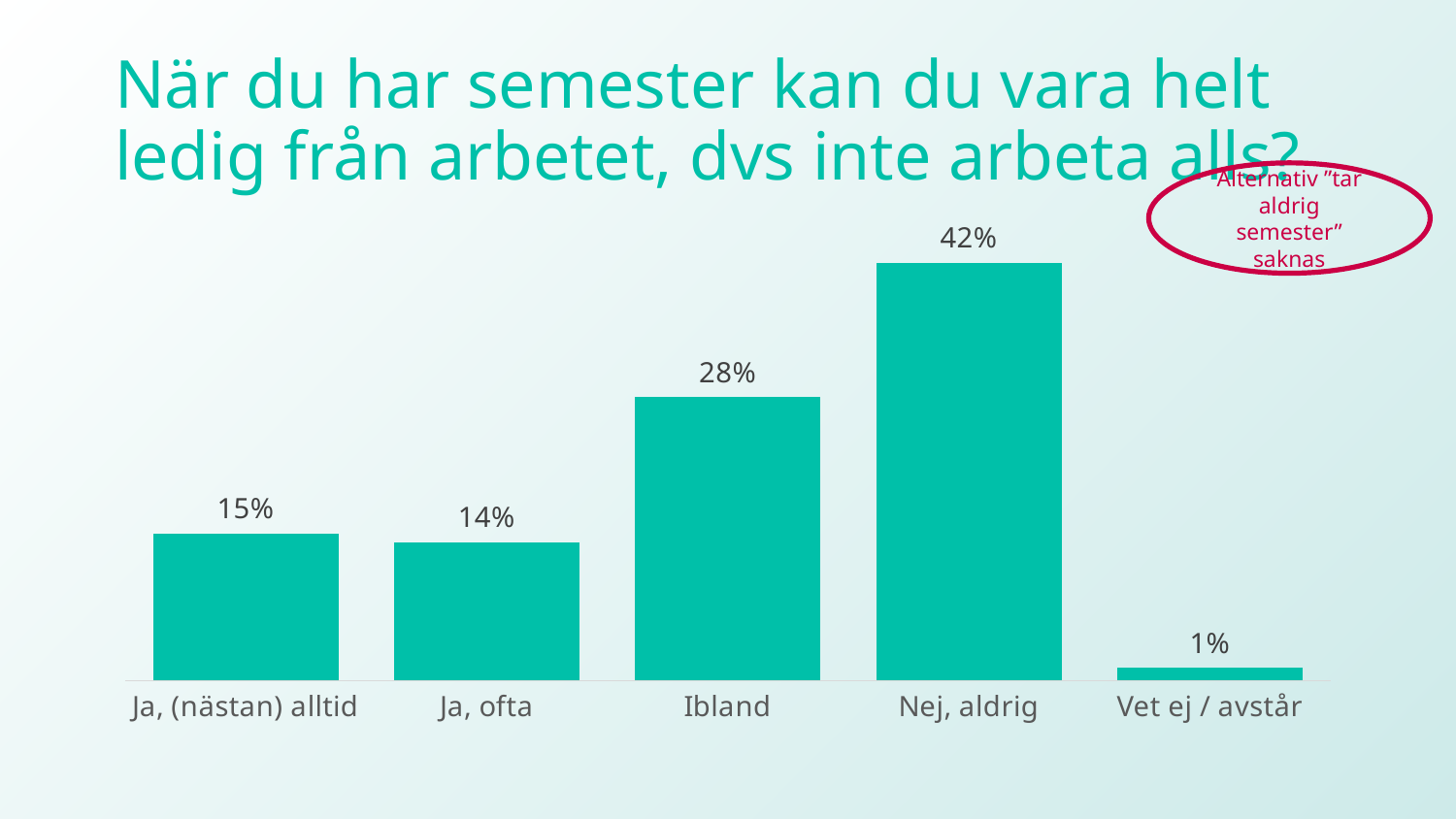
What kind of chart is shown on the slide? Bar chart What is the value for "Nej, aldrig"? 42% What does the red circled note on the slide say is missing? Alternativ "tar aldrig semester" saknas How many categories are shown in the chart? 5 Which is larger, the value for "Ibland" or the value for "Ja, ofta"? Ibland What is the difference between the values for "Nej, aldrig" and "Ibland"? 14% What is the value for "Ibland"? 28% What is the value for "Ja, (nästan) alltid"? 15% Which category has the highest value? Nej, aldrig What is the difference between the values for "Ja, (nästan) alltid" and "Ja, ofta"? 1% Which category has the lowest value? Vet ej / avstår What is the value for "Vet ej / avstår"? 1%